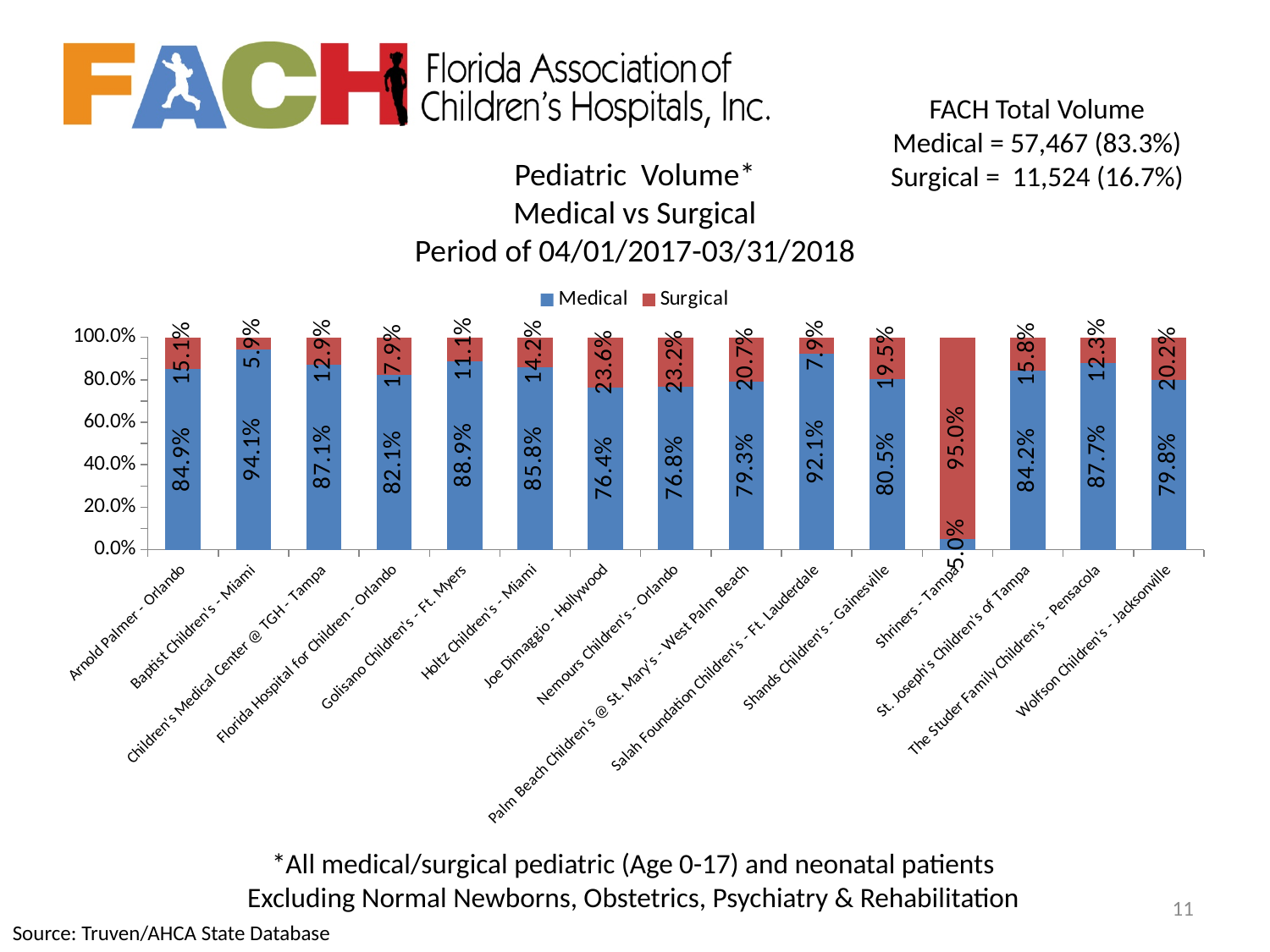
What is the Surgical percentage for Joe Dimaggio - Hollywood? 23.6% What is the Medical percentage for Baptist Children's - Miami? 94.1% What is the difference between the Surgical percentages of Nemours Children's - Orlando and Salah Foundation Children's - Ft. Lauderdale? 15.3% Which hospital has the lowest Medical percentage? Shriners - Tampa What kind of chart is shown on the slide? Stacked bar chart Which hospital has the highest Medical percentage? Baptist Children's - Miami Which colour represents the Surgical series in the chart? Red What is the Surgical percentage for Shriners - Tampa? 95.0% How many hospitals are shown on the x axis of the chart? 15 Which has a larger Medical percentage, Golisano Children's - Ft. Myers or Holtz Children's - Miami? Golisano Children's - Ft. Myers What is the total of the Medical and Surgical segments for Wolfson Children's - Jacksonville? 100.0% How many series does the chart legend list? 2